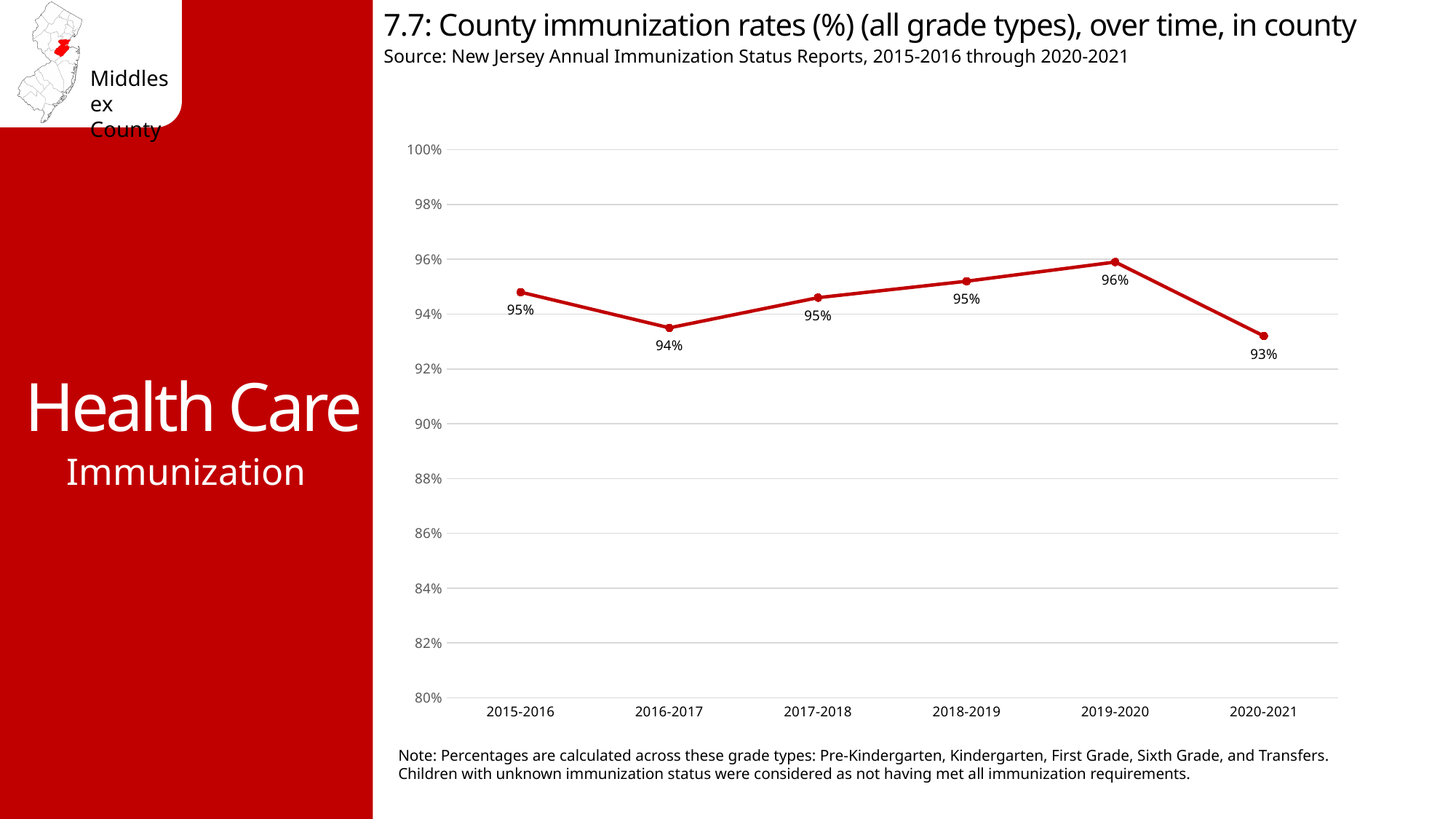
Which is larger, the immunization rate for 2019-2020 or for 2016-2017? 2019-2020 What is the immunization rate for 2016-2017? 94% Does the immunization rate rise or fall from 2019-2020 to 2020-2021? fall What kind of chart is shown on the slide? line chart Is the value for 2020-2021 greater or less than 94%? less What is the immunization rate for 2015-2016? 95% Which school year has the lowest immunization rate? 2020-2021 What is the immunization rate for 2020-2021? 93% What is the difference between the immunization rate in 2019-2020 and in 2020-2021, using the printed labels? 3 percentage points How many school years are plotted on the chart? 6 Which school year has the highest immunization rate? 2019-2020 What is the immunization rate for 2019-2020? 96%